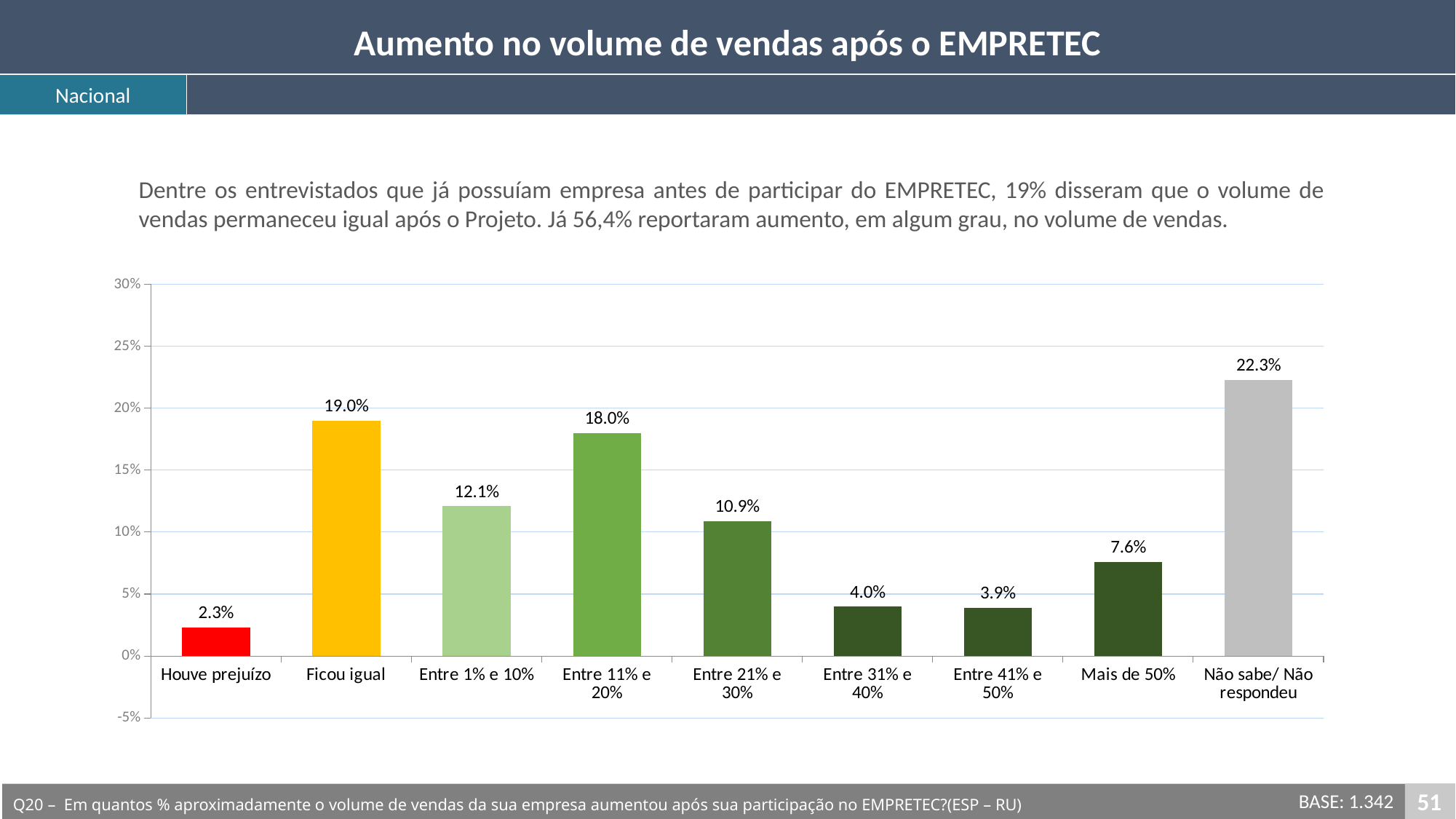
What is the value for "Ficou igual"? 19.0% Which category has the highest value? Não sabe/ Não respondeu What is the value for "Entre 11% e 20%"? 18.0% What kind of chart is shown on the slide? bar chart Which is larger, "Ficou igual" or "Entre 11% e 20%"? Ficou igual What colour is the bar for "Houve prejuízo"? red What is the difference between "Entre 1% e 10%" and "Entre 21% e 30%"? 1.2% How many categories are shown on the x axis? 9 Which category has the lowest value? Houve prejuízo What is the value for "Houve prejuízo"? 2.3% What is the value for "Mais de 50%"? 7.6% Is the value for "Não sabe/ Não respondeu" greater or less than 20%? greater